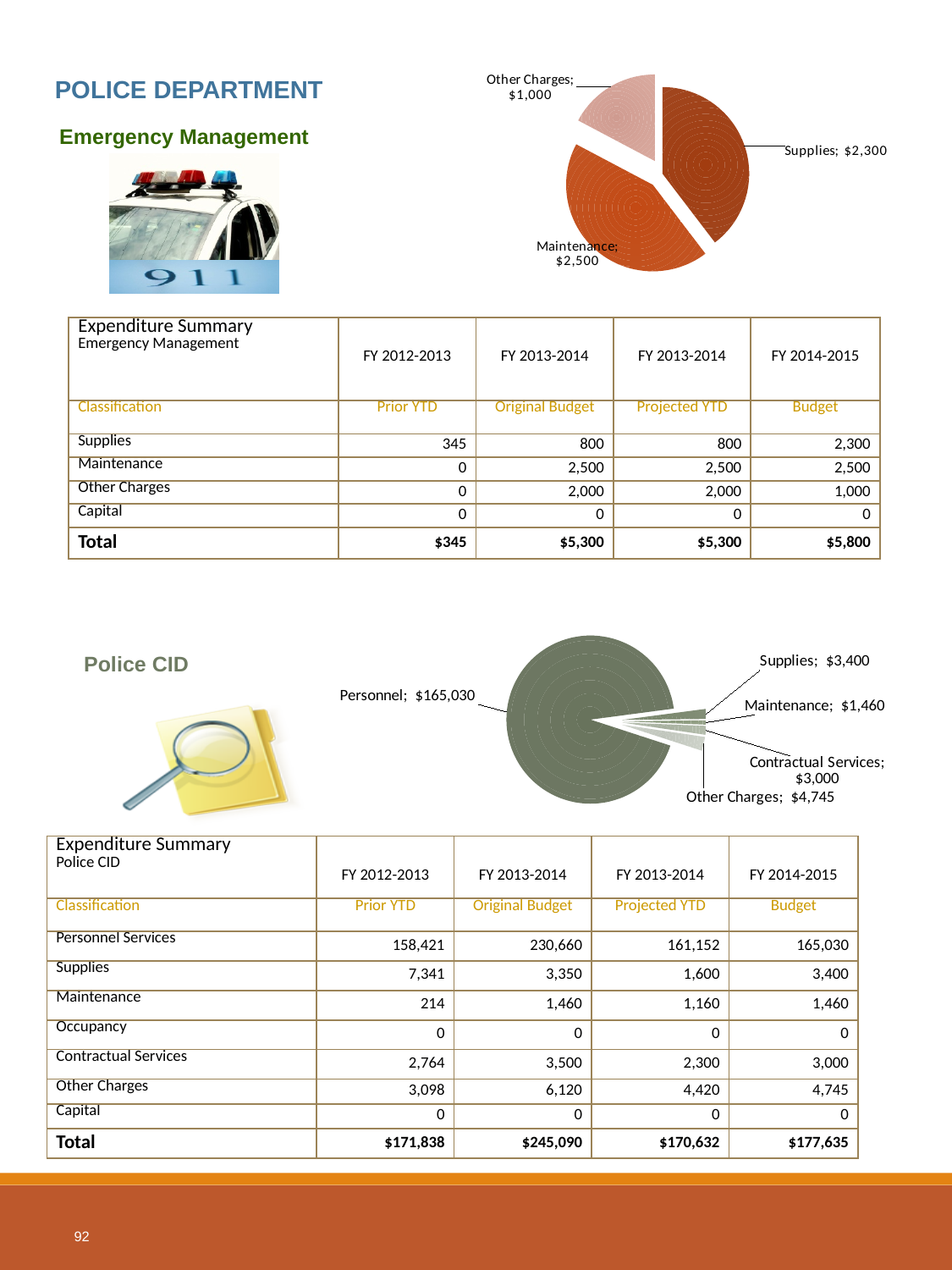
In the Police CID pie chart, which category has the smallest value? Maintenance In the Emergency Management pie chart, what is the value for Supplies? $2,300 In the Police CID pie chart, what is the difference between Supplies and Contractual Services? $400 In the Emergency Management pie chart, what is the difference between Maintenance and Supplies? $200 In the Emergency Management pie chart, which category has the smallest value? Other Charges In the Police CID pie chart, what is the total of all slices? $177,635 In the Police CID pie chart, which is larger: Other Charges or Supplies? Other Charges In the Police CID pie chart, what is the value for Personnel? $165,030 How many slices does the Police CID pie chart have? 5 In the Emergency Management pie chart, which category has the largest value? Maintenance What kind of chart is the Emergency Management chart at the top of the slide? pie chart How many slices does the Emergency Management pie chart have? 3